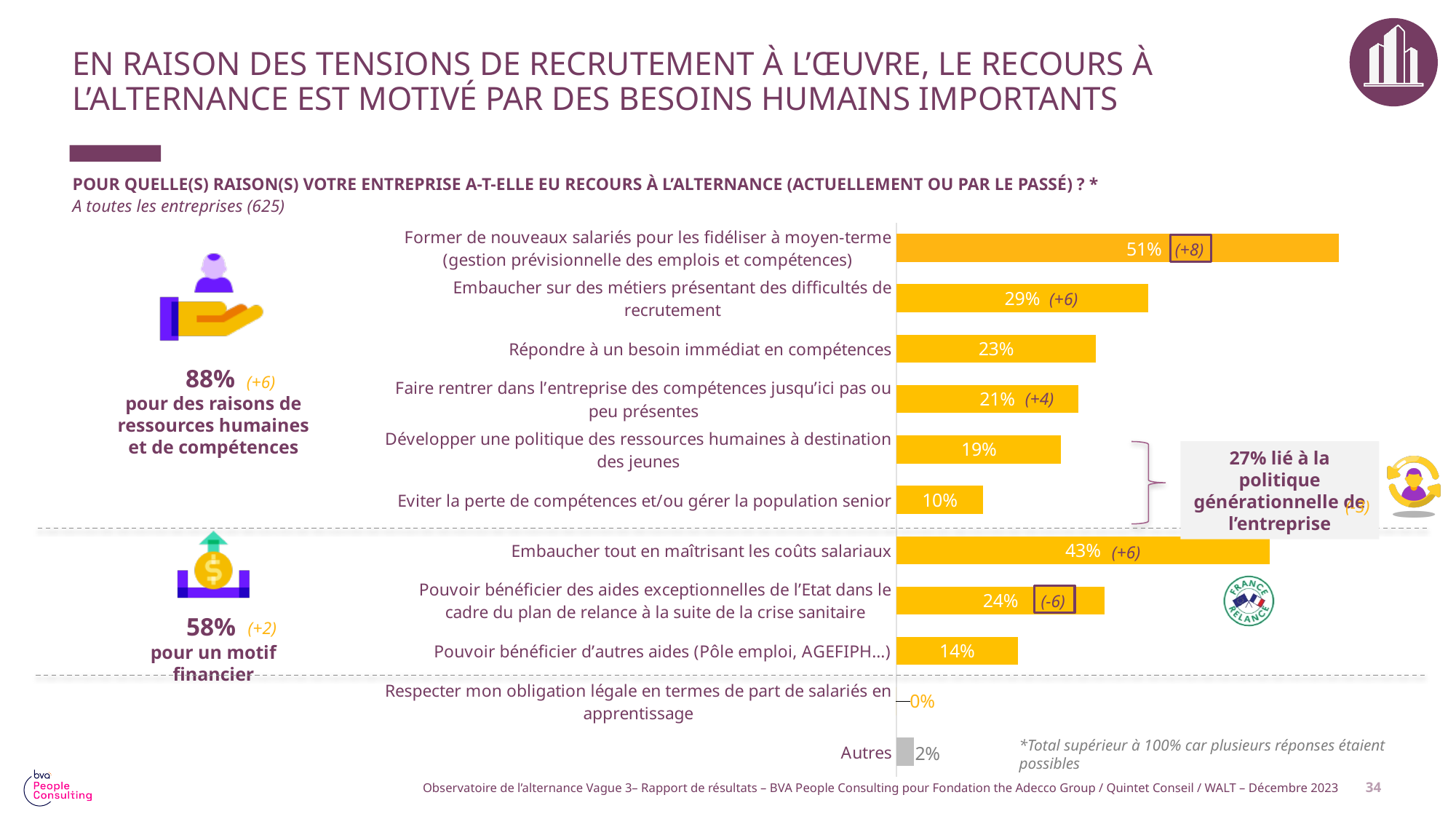
What is the difference between the values for "Embaucher sur des métiers présentant des difficultés de recrutement" and "Répondre à un besoin immédiat en compétences"? 6 percentage points What is the value for "Eviter la perte de compétences et/ou gérer la population senior"? 10% What kind of chart is shown on the slide? Bar chart What is the value for "Autres"? 2% Which reason has the lowest percentage in the chart? Respecter mon obligation légale en termes de part de salariés en apprentissage What percentage of companies cite "Former de nouveaux salariés pour les fidéliser à moyen-terme" as a reason for using alternance? 51% Which is larger: the value for "Embaucher tout en maîtrisant les coûts salariaux" or the value for "Pouvoir bénéficier des aides exceptionnelles de l'Etat"? Embaucher tout en maîtrisant les coûts salariaux Which reason has the highest percentage in the chart? Former de nouveaux salariés pour les fidéliser à moyen-terme How many reasons (categories) are plotted in the bar chart? 11 What is the change shown in parentheses next to the 51% bar? (+8) What is the value for "Embaucher tout en maîtrisant les coûts salariaux"? 43% What is the value for "Pouvoir bénéficier d'autres aides (Pôle emploi, AGEFIPH…)"? 14%